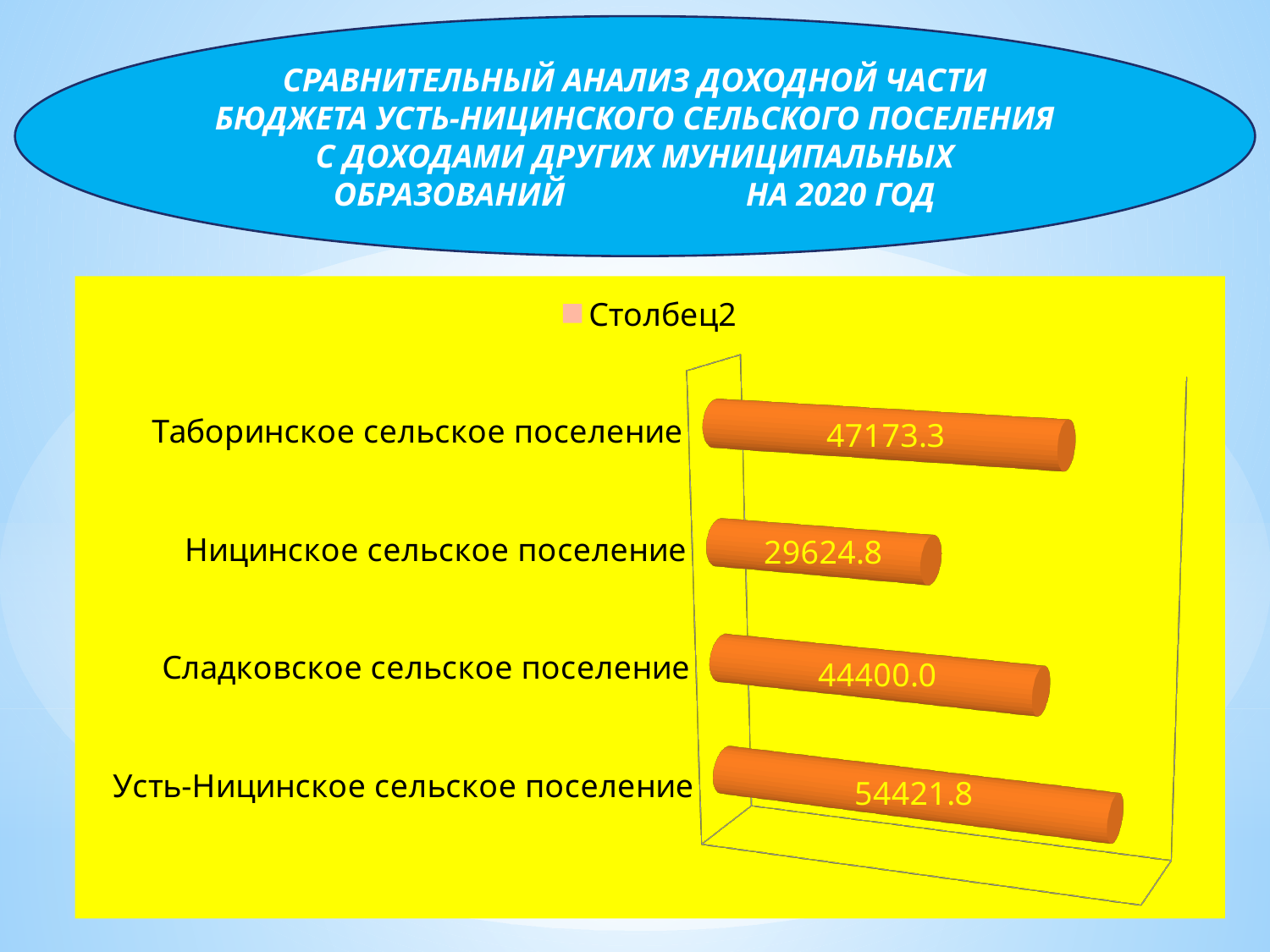
Which is larger, the value for Сладковское сельское поселение or the value for Ницинское сельское поселение? Сладковское сельское поселение What is the value for Сладковское сельское поселение? 44400.0 What is the value for Ницинское сельское поселение? 29624.8 Which settlement has the highest value? Усть-Ницинское сельское поселение What is the legend entry shown above the chart? Столбец2 How many settlements are shown in the chart? 4 What kind of chart is shown on the slide? Bar chart Which settlement has the lowest value? Ницинское сельское поселение What is the difference between the values for Усть-Ницинское сельское поселение and Таборинское сельское поселение? 7248.5 What is the value for Усть-Ницинское сельское поселение? 54421.8 What is the value for Таборинское сельское поселение? 47173.3 What is the difference between the values for Таборинское сельское поселение and Ницинское сельское поселение? 17548.5